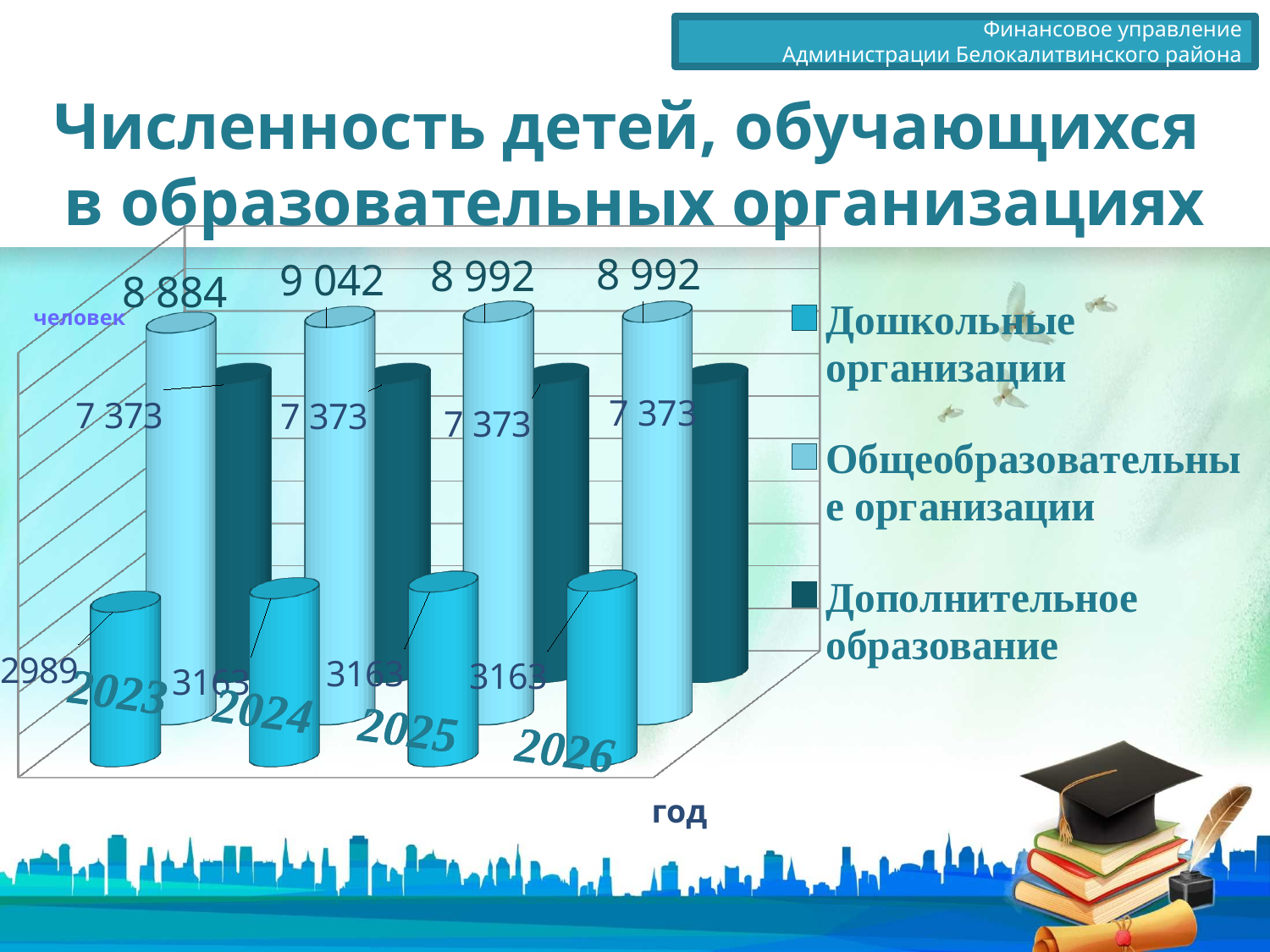
What is the value for Дошкольные организации in 2023? 2989 What is the value for Дополнительное образование in 2026? 7 373 How many series does the legend list? 3 In which year is the value for Общеобразовательные организации highest? 2024 What kind of chart is shown on the slide? bar chart What is the difference between the Общеобразовательные организации values for 2024 and 2023? 158 What is the value for Общеобразовательные организации in 2025? 8 992 Does the value for Дополнительное образование change from 2023 to 2026? No, it stays at 7 373 How many years are shown on the x axis? 4 Which is larger in 2025: the value for Общеобразовательные организации or for Дополнительное образование? Общеобразовательные организации In which year is the value for Дошкольные организации lowest? 2023 What is the value for Общеобразовательные организации in 2024? 9 042